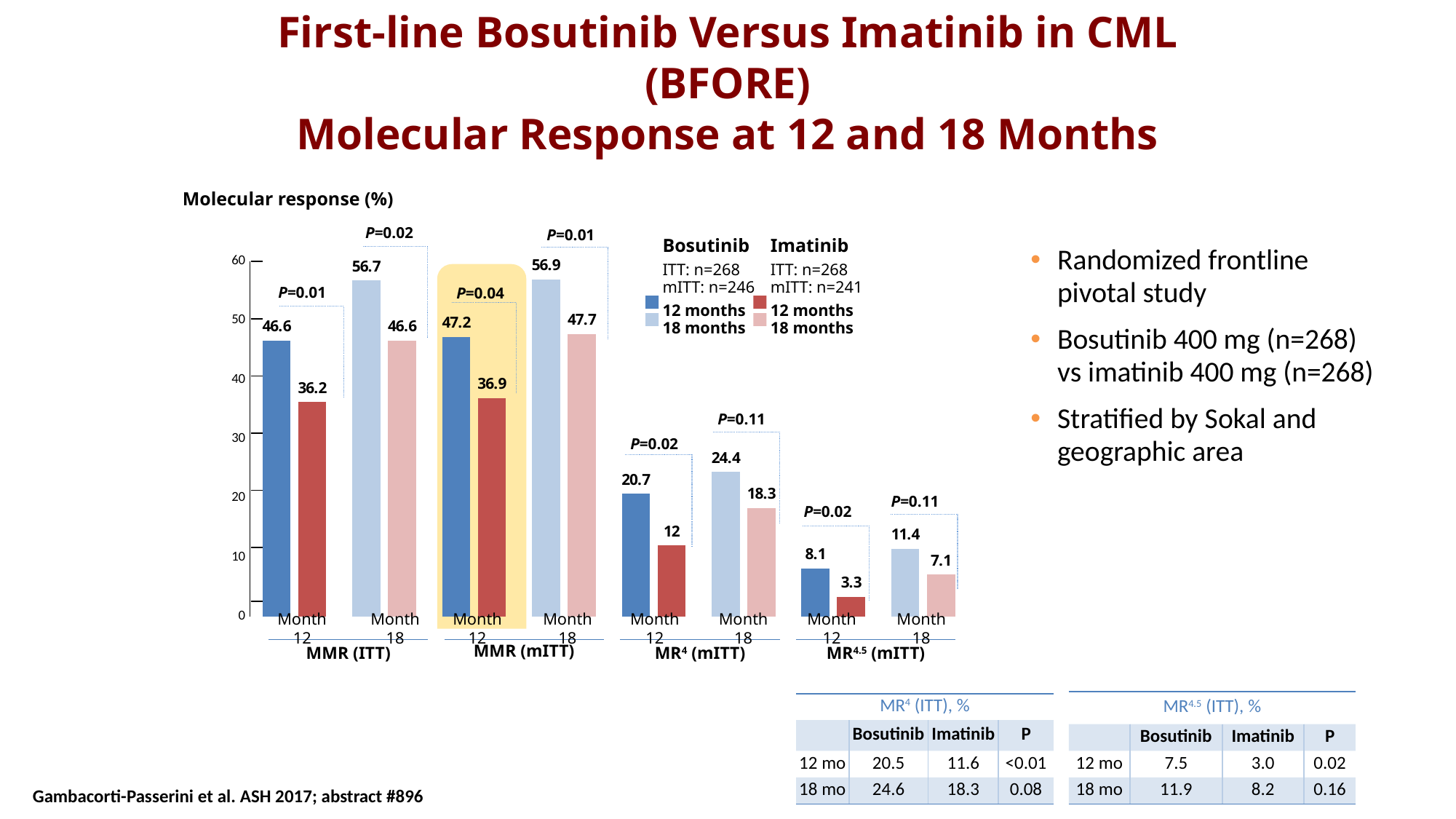
What is the molecular response (%) for imatinib at Month 18 in the MMR (mITT) group? 47.7 What kind of chart is shown on the slide? Bar chart What P value is shown for the Month 12 comparison in the MMR (mITT) group? P=0.04 How many series does the chart legend list? 4 Which bar in the chart has the highest molecular response (%)? Bosutinib, Month 18, MMR (mITT) (56.9) At Month 18 in the MR4.5 (mITT) group, which drug has the higher molecular response (%), bosutinib or imatinib? Bosutinib What is the molecular response (%) for bosutinib at Month 12 in the MMR (ITT) group? 46.6 What is the difference between the bosutinib and imatinib molecular response (%) at Month 12 in the MMR (ITT) group? 10.4 Which bar in the chart has the lowest molecular response (%)? Imatinib, Month 12, MR4.5 (mITT) (3.3) Is the bosutinib molecular response (%) at Month 12 in the MR4 (mITT) group greater or less than 30? less What is the difference between the bosutinib and imatinib molecular response (%) at Month 18 in the MR4 (mITT) group? 6.1 What is the molecular response (%) for imatinib at Month 12 in the MR4.5 (mITT) group? 3.3